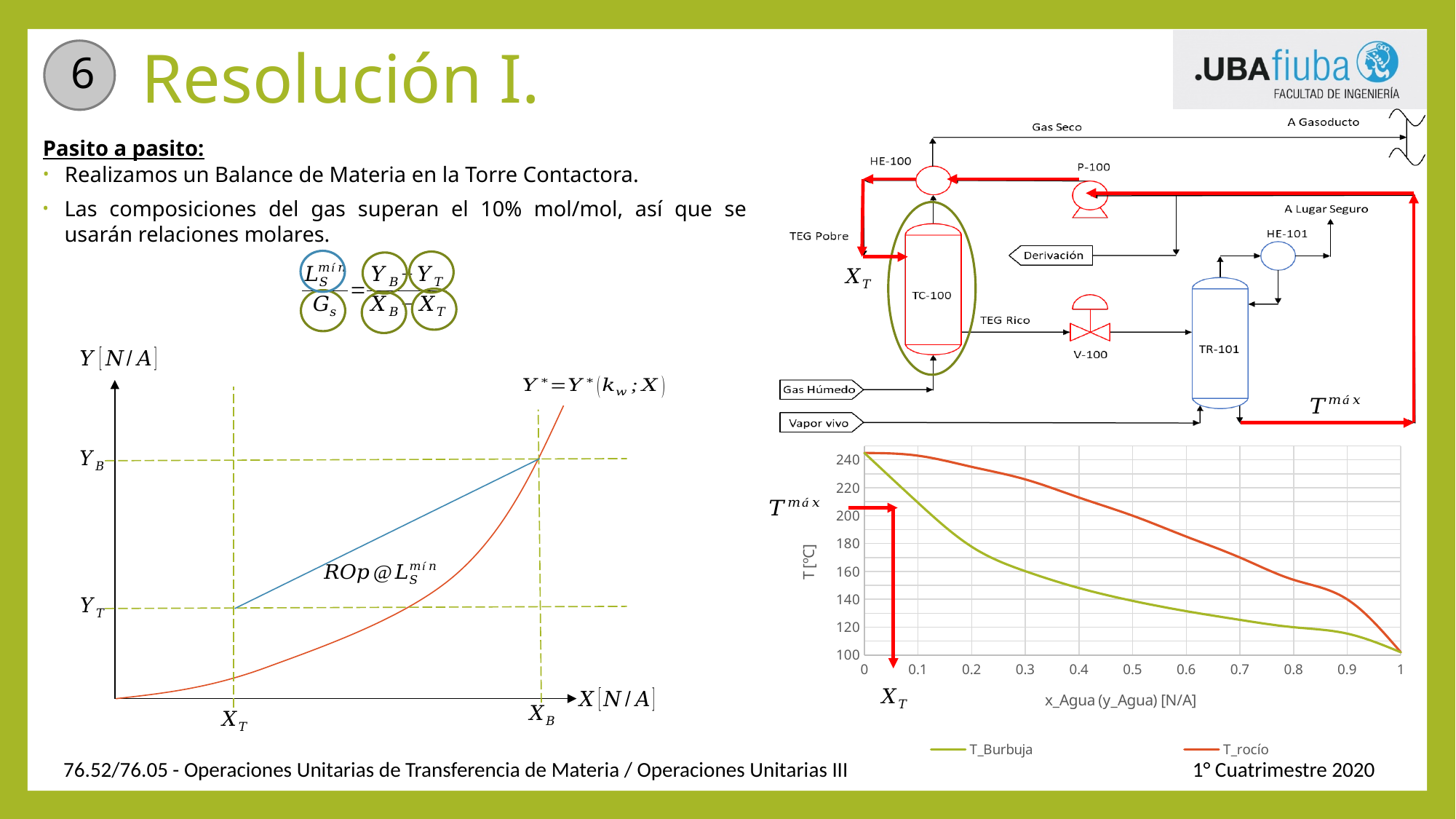
In the bottom-right chart, what are the names of the two series in the legend? T_Burbuja and T_rocío What kind of chart is the bottom-right chart of temperature versus x_Agua? Line chart In the bottom-right chart, what is the label of the vertical axis? T [°C] In the bottom-right chart, is the T_rocío value at x_Agua = 0.5 greater or less than 180? greater What kind of chart is the X–Y diagram on the left of the slide? Line chart In the bottom-right chart, is the T_Burbuja value at x_Agua = 0.5 greater or less than 160? less In the bottom-right chart, do the T_Burbuja values rise or fall as x_Agua increases from 0 to 1? Fall In the bottom-right chart, is the T_rocío value at x_Agua = 0.7 greater or less than 160? greater In the bottom-right chart, at x_Agua = 0.5, which series has the higher temperature, T_Burbuja or T_rocío? T_rocío In the bottom-right chart, how many series does the legend list? 2